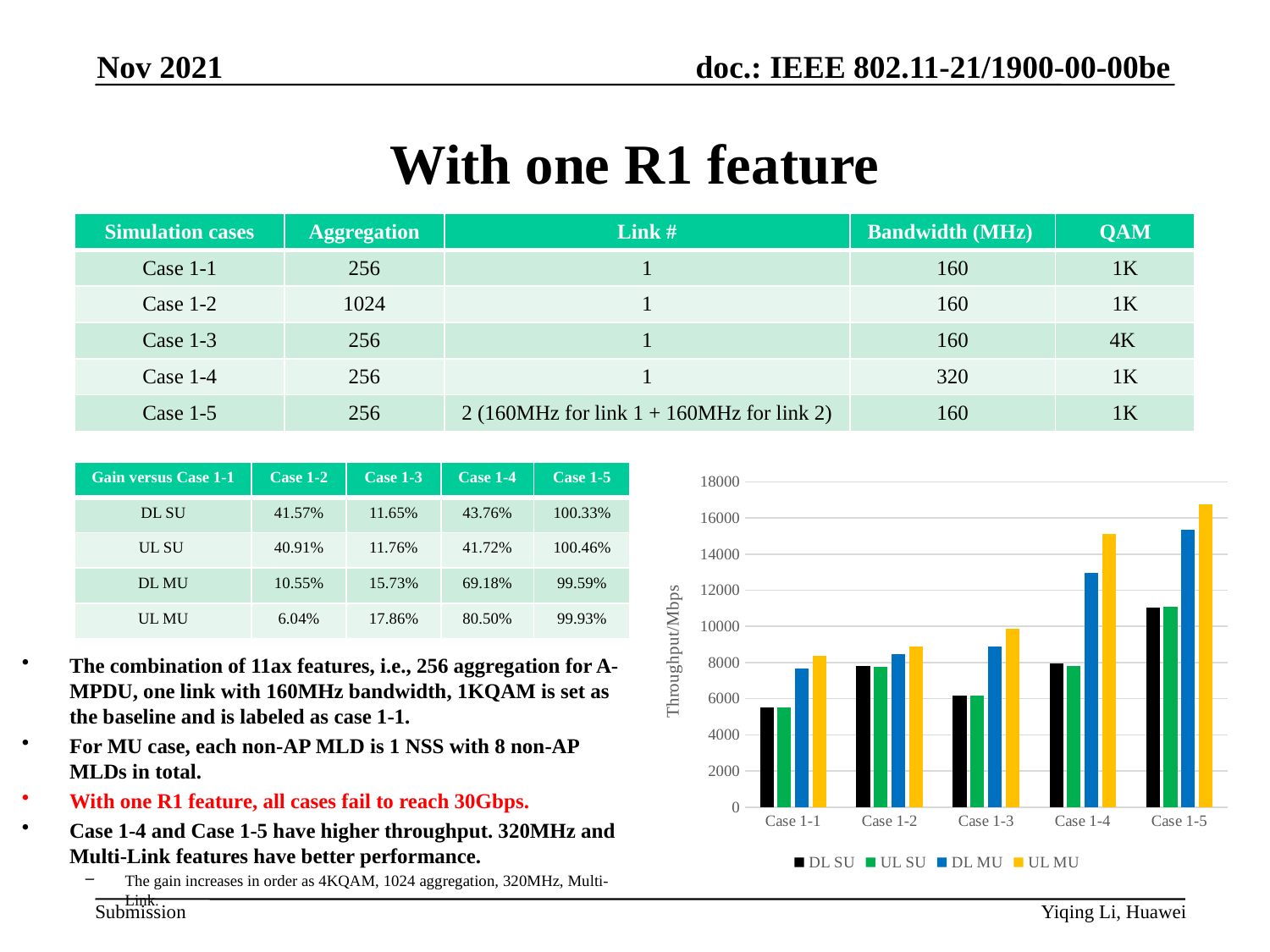
Is the UL MU value for Case 1-4 greater or less than 14000? greater How many series does the chart legend list? 4 Which series are listed in the chart legend? DL SU, UL SU, DL MU, UL MU Which case has the highest UL MU throughput? Case 1-5 How many cases are shown along the x axis of the chart? 5 What is the label of the vertical axis of the chart? Throughput/Mbps Does the UL MU throughput rise or fall from Case 1-1 to Case 1-5? rise Is the UL MU value for Case 1-5 greater or less than 16000? greater Which is larger, the DL MU value for Case 1-4 or the DL MU value for Case 1-3? Case 1-4 Is the DL SU value for Case 1-1 greater or less than 6000? less Which case has the lowest DL MU throughput? Case 1-1 What kind of chart is shown on the slide? bar chart